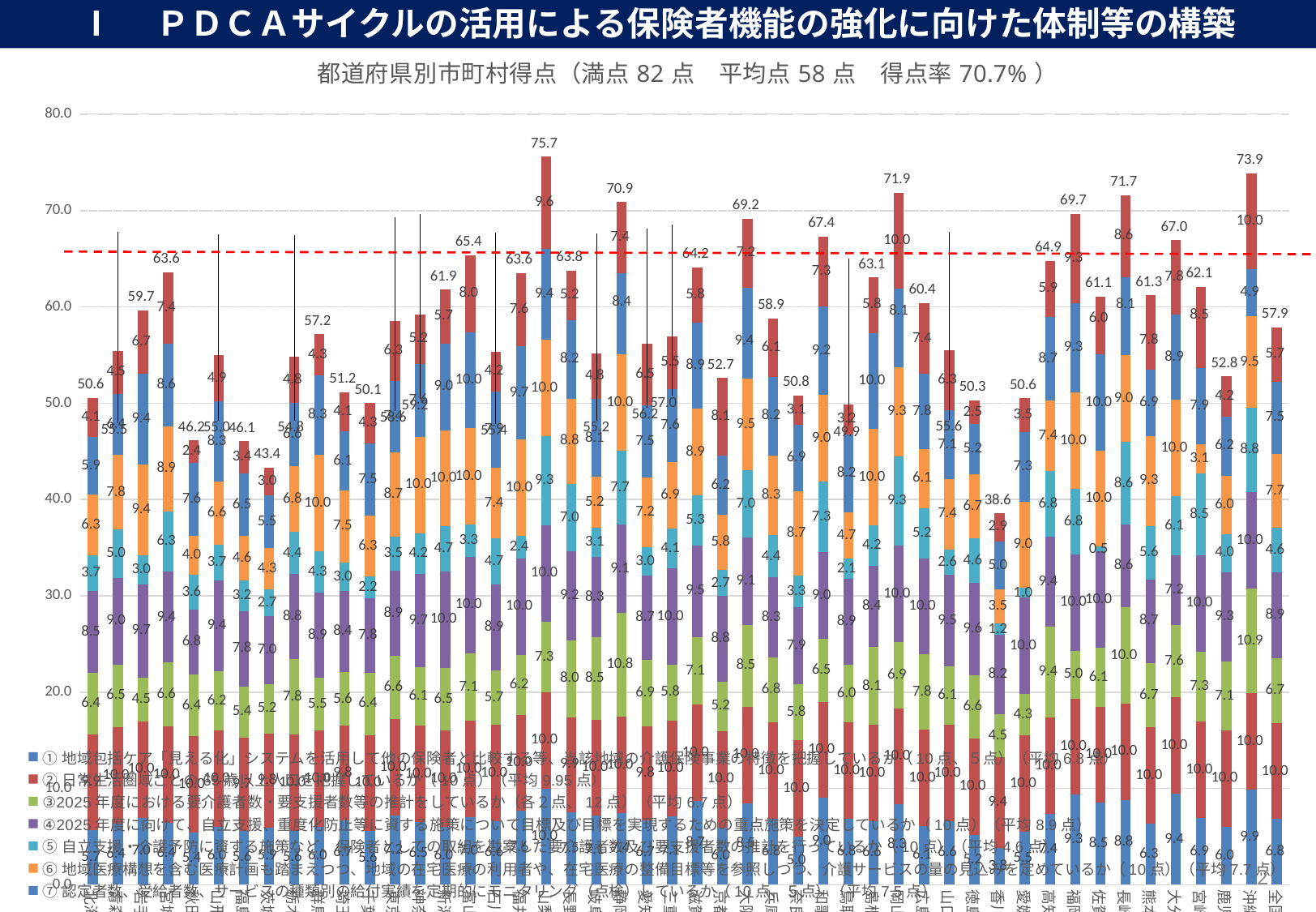
What is the maximum value shown on the vertical axis? 80.0 What is the lowest total value printed above any bar? 38.6 What is the difference between the highest bar total (75.7) and the lowest bar total (38.6)? 37.1 Is the total of the lowest bar (38.6) greater or less than 40.0? less What is the highest total value printed above any bar? 75.7 What is the title of the chart? 都道府県別市町村得点（満点 82 点 平均点 58 点 得点率 70.7%） What is the total printed above the rightmost bar? 57.9 Which is larger, the total of the leftmost bar or the total of the rightmost bar? The rightmost bar What kind of chart is shown on the slide? Stacked bar chart How many series does the legend list? 7 What is the total printed above the leftmost bar? 50.6 How many bars are plotted in the chart? 48